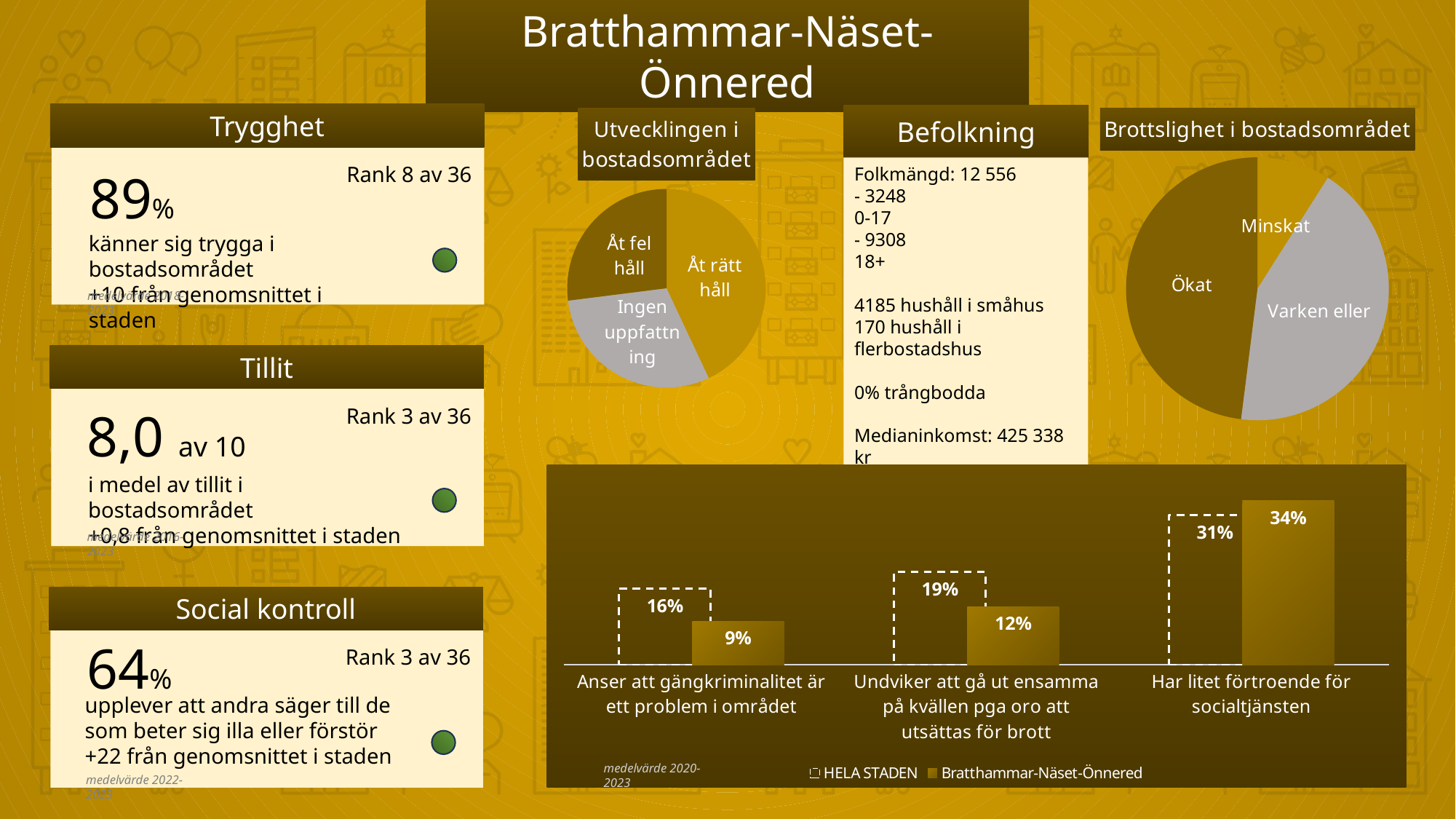
In the bar chart at the bottom, what is the value for Bratthammar-Näset-Önnered for 'Anser att gängkriminalitet är ett problem i området'? 9% In the bar chart at the bottom, how many categories are shown on the x axis? 3 In the pie chart titled 'Brottslighet i bostadsområdet', which slice is the smallest? Minskat What kind of chart is the chart titled 'Brottslighet i bostadsområdet'? Pie chart In the bar chart at the bottom, which category has the lowest value for HELA STADEN? Anser att gängkriminalitet är ett problem i området In the bar chart at the bottom, for 'Har litet förtroende för socialtjänsten', which is larger: HELA STADEN or Bratthammar-Näset-Önnered? Bratthammar-Näset-Önnered In the bar chart at the bottom, what is the value for Bratthammar-Näset-Önnered for 'Har litet förtroende för socialtjänsten'? 34% How many slices does the pie chart titled 'Utvecklingen i bostadsområdet' have? 3 In the bar chart at the bottom, which category has the highest value for Bratthammar-Näset-Önnered? Har litet förtroende för socialtjänsten In the bar chart at the bottom, what is the difference between HELA STADEN and Bratthammar-Näset-Önnered for 'Anser att gängkriminalitet är ett problem i området'? 7% In the bar chart at the bottom, how many series does the legend list? 2 In the bar chart at the bottom, what is the value for HELA STADEN for 'Undviker att gå ut ensamma på kvällen pga oro att utsättas för brott'? 19%